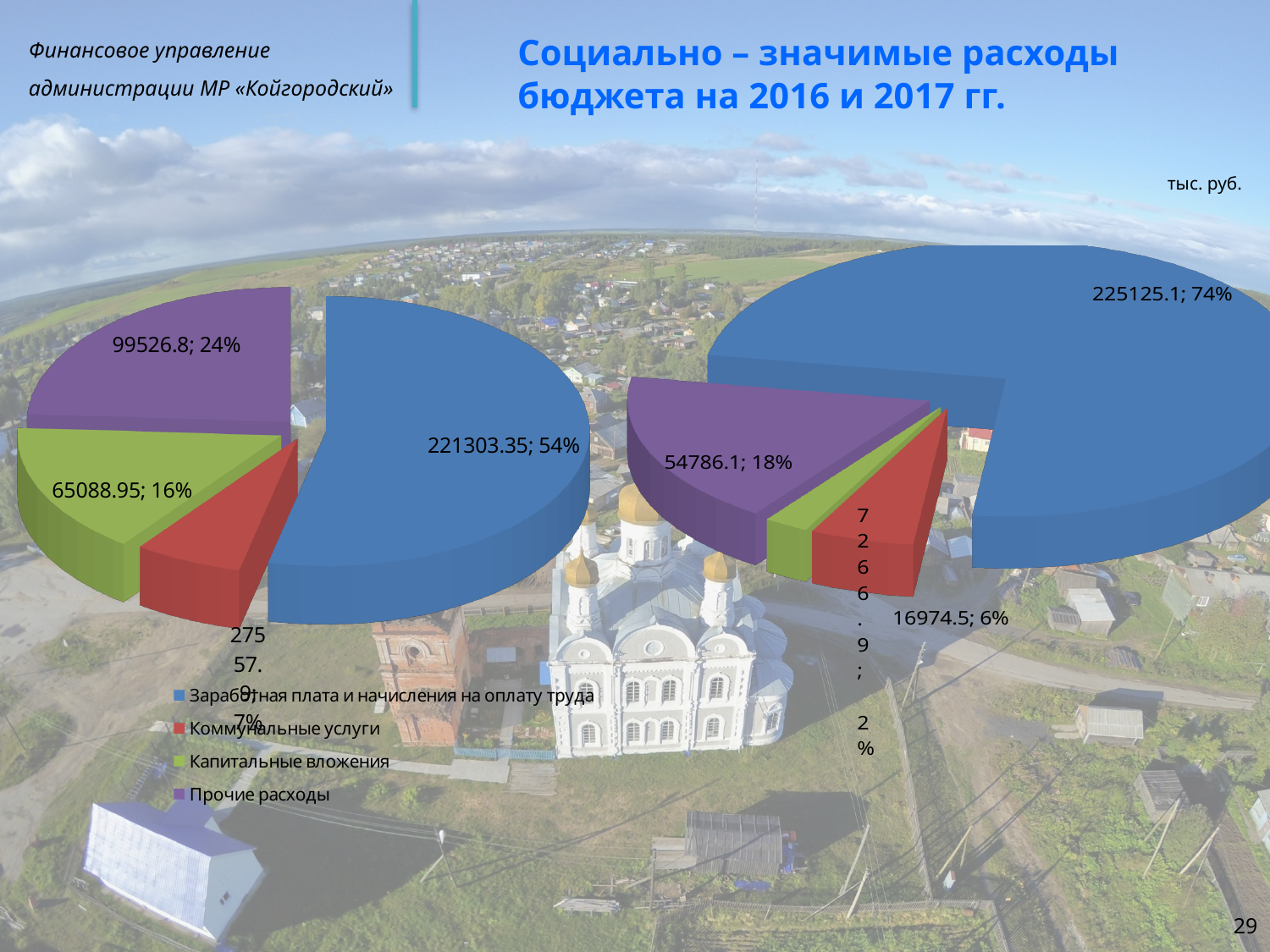
In the left pie chart, what value is shown for the green slice (Капитальные вложения)? 65088.95 In the right pie chart, which category has the largest slice? Заработная плата и начисления на оплату труда How many categories does the legend list? 4 What unit is indicated for the values on the slide? тыс. руб. In the left pie chart, which category has the smallest slice? Коммунальные услуги In the right pie chart, what share does the purple slice (Прочие расходы) have? 18% What kind of charts are shown on the slide? Pie charts In the right pie chart, what value is shown for the blue slice (Заработная плата и начисления на оплату труда)? 225125.1 In the left pie chart, what share does the purple slice (Прочие расходы) have? 24% In the left pie chart, what value is shown for the blue slice (Заработная плата и начисления на оплату труда)? 221303.35 In the right pie chart, which is larger: the purple slice (Прочие расходы) or the red slice (Коммунальные услуги)? Прочие расходы In the right pie chart, what value is shown for the red slice (Коммунальные услуги)? 16974.5